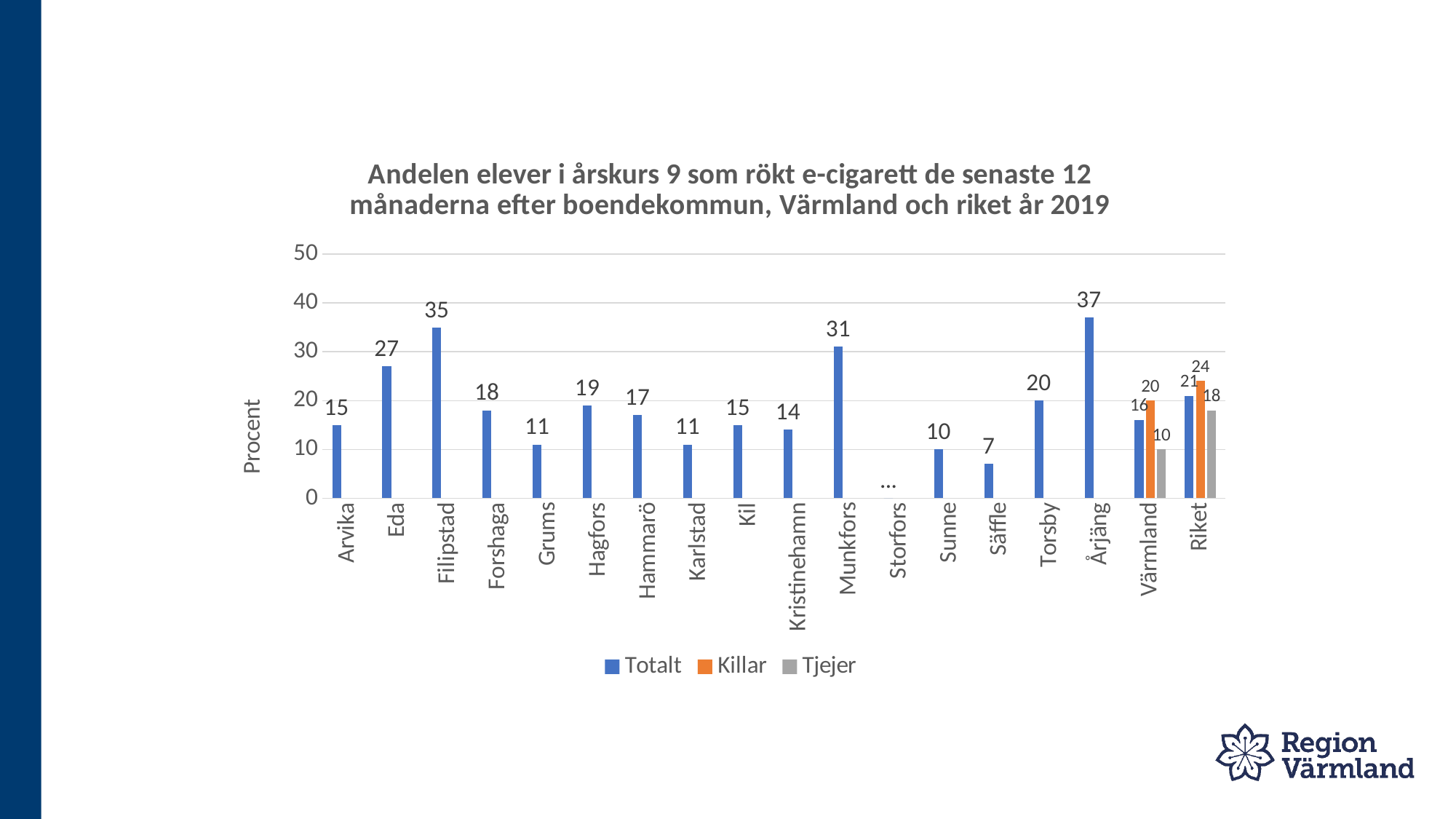
What is the Tjejer value for Värmland? 10 How many categories are shown on the x axis? 18 How many series does the legend list? 3 Which municipality has the lowest Totalt value among those with a plotted bar? Säffle What is the Killar value for Riket? 24 What kind of chart is shown on the slide? Bar chart Which municipality has the highest Totalt value? Årjäng Which has a higher Totalt value, Hagfors or Hammarö? Hagfors Which category shows '...' instead of a bar? Storfors What is the Totalt value for Filipstad? 35 What is the difference between the Totalt values for Munkfors and Eda? 4 Is the Totalt value for Årjäng greater or less than 30? greater